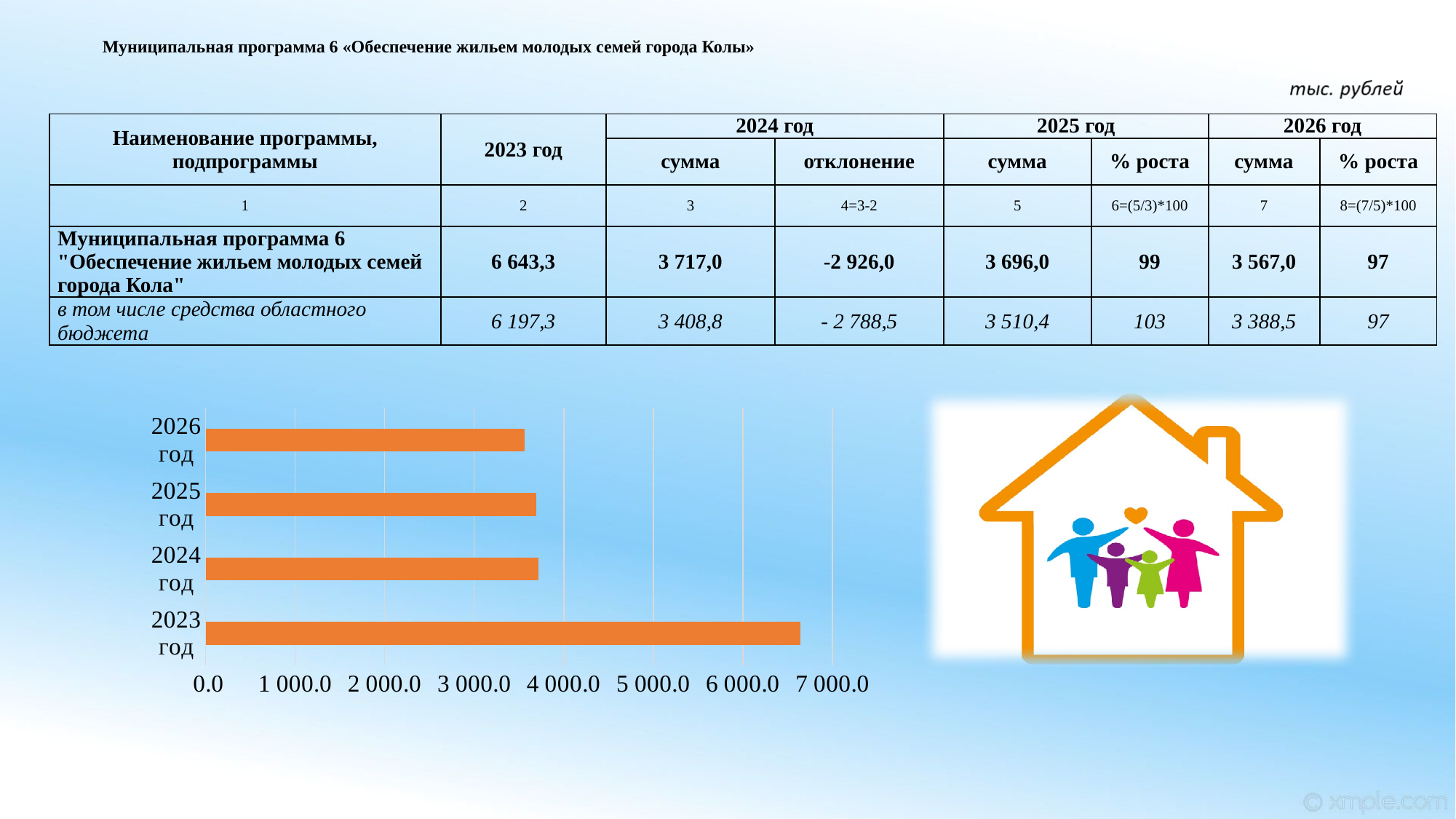
Which year has the longest bar in the chart? 2023 год Is the value for 2023 год greater or less than 6 000.0? greater Is the value for 2026 год greater or less than 4 000.0? less Do the values rise or fall from 2023 год to 2026 год? fall Is the value for 2024 год greater or less than 4 000.0? less Which is larger, the value for 2023 год or the value for 2024 год? 2023 год What kind of chart is shown on the slide? bar chart How many categories (years) are plotted in the bar chart? 4 What is the highest tick value shown on the horizontal axis of the chart? 7 000.0 What colour are the bars in the chart? orange Which is larger, the value for 2023 год or the value for 2026 год? 2023 год